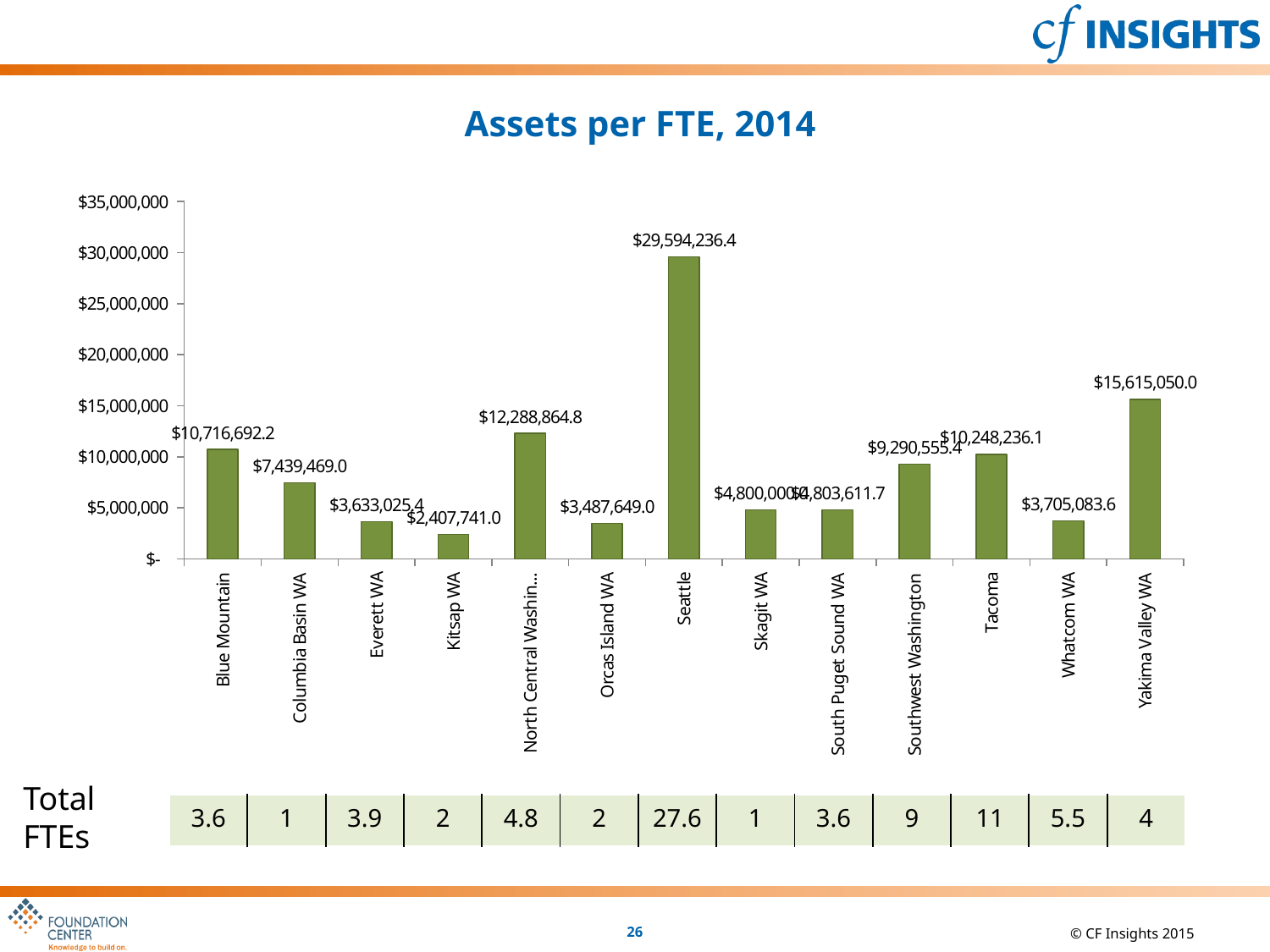
What kind of chart is shown on the slide? bar chart What is the assets per FTE value for Blue Mountain? $10,716,692.2 Is the assets per FTE value for Whatcom WA greater or less than $5,000,000? less What is the difference in assets per FTE between Seattle and Yakima Valley WA? $13,979,186.4 According to the Total FTEs row below the chart, how many total FTEs does Seattle have? 27.6 What is the assets per FTE value for Yakima Valley WA? $15,615,050.0 Which has higher assets per FTE, Columbia Basin WA or Southwest Washington? Southwest Washington What is the assets per FTE value for Seattle? $29,594,236.4 Which foundation has the lowest assets per FTE? Kitsap WA Which foundation has the highest assets per FTE? Seattle How many foundations are shown on the x axis of the chart? 13 What is the title of the chart? Assets per FTE, 2014